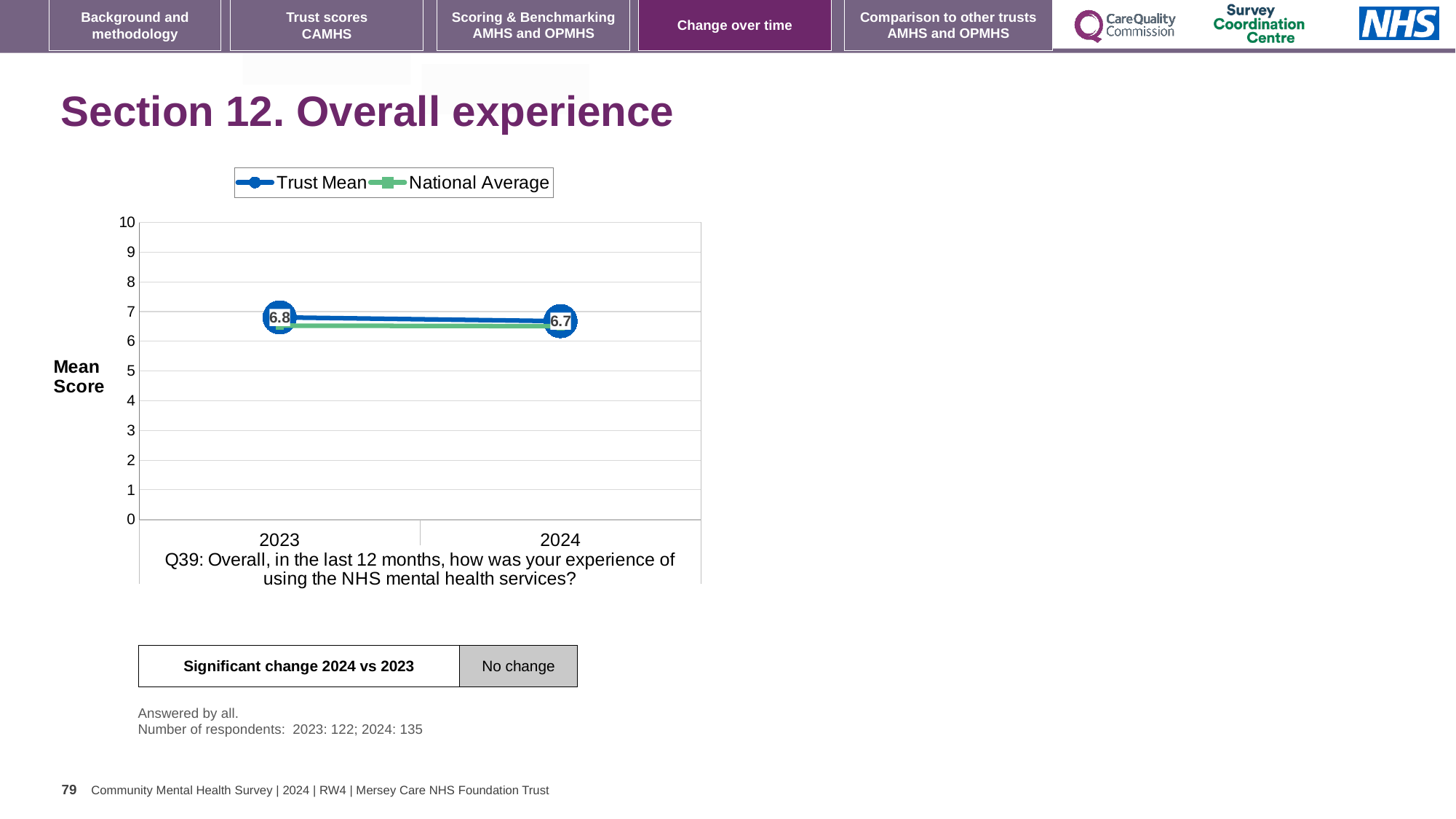
How many series does the legend list? 2 What kind of chart is shown on the slide? line chart What is the label of the y axis? Mean Score How many years are plotted on the x axis? 2 What is the Trust Mean score for 2024? 6.7 Is the Trust Mean value for 2023 greater or less than 8? less Is the National Average value for 2024 greater or less than 5? greater Does the Trust Mean rise or fall from 2023 to 2024? fall In which year was the Trust Mean higher? 2023 What is the Trust Mean score for 2023? 6.8 Which series is plotted with the blue line? Trust Mean By how much did the Trust Mean change from 2023 to 2024? 0.1